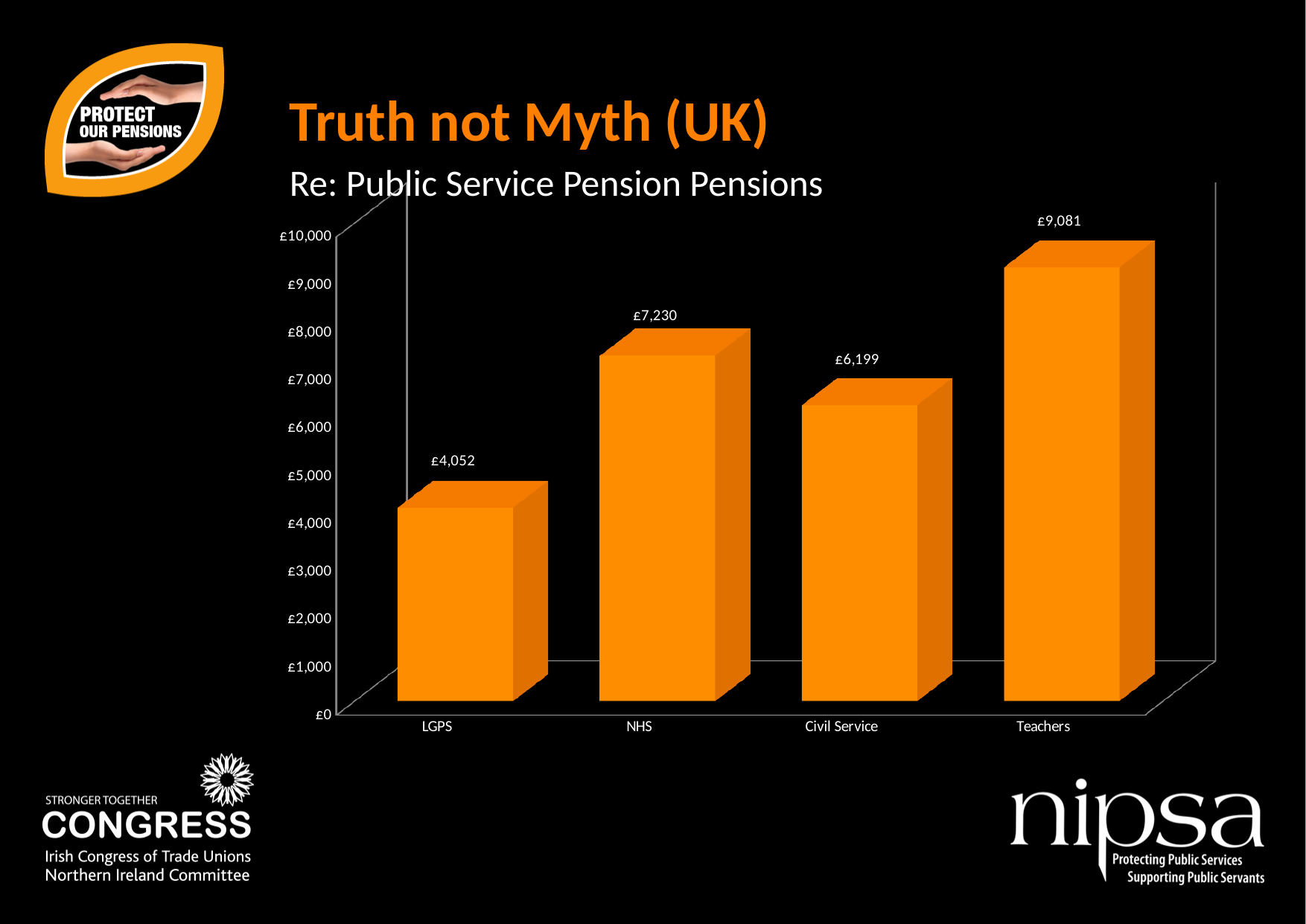
What is the difference between the values for Teachers and LGPS? £5,029 What kind of chart is shown on the slide? bar chart How many categories are shown on the chart? 4 Which category has the highest value? Teachers What is the value for Civil Service? £6,199 What is the value for Teachers? £9,081 Which category has the lowest value? LGPS What is the value for NHS? £7,230 What is the value for LGPS? £4,052 What is the difference between the values for NHS and Civil Service? £1,031 Which is larger, the value for NHS or the value for Civil Service? NHS Is the value for Civil Service greater or less than £7,000? less